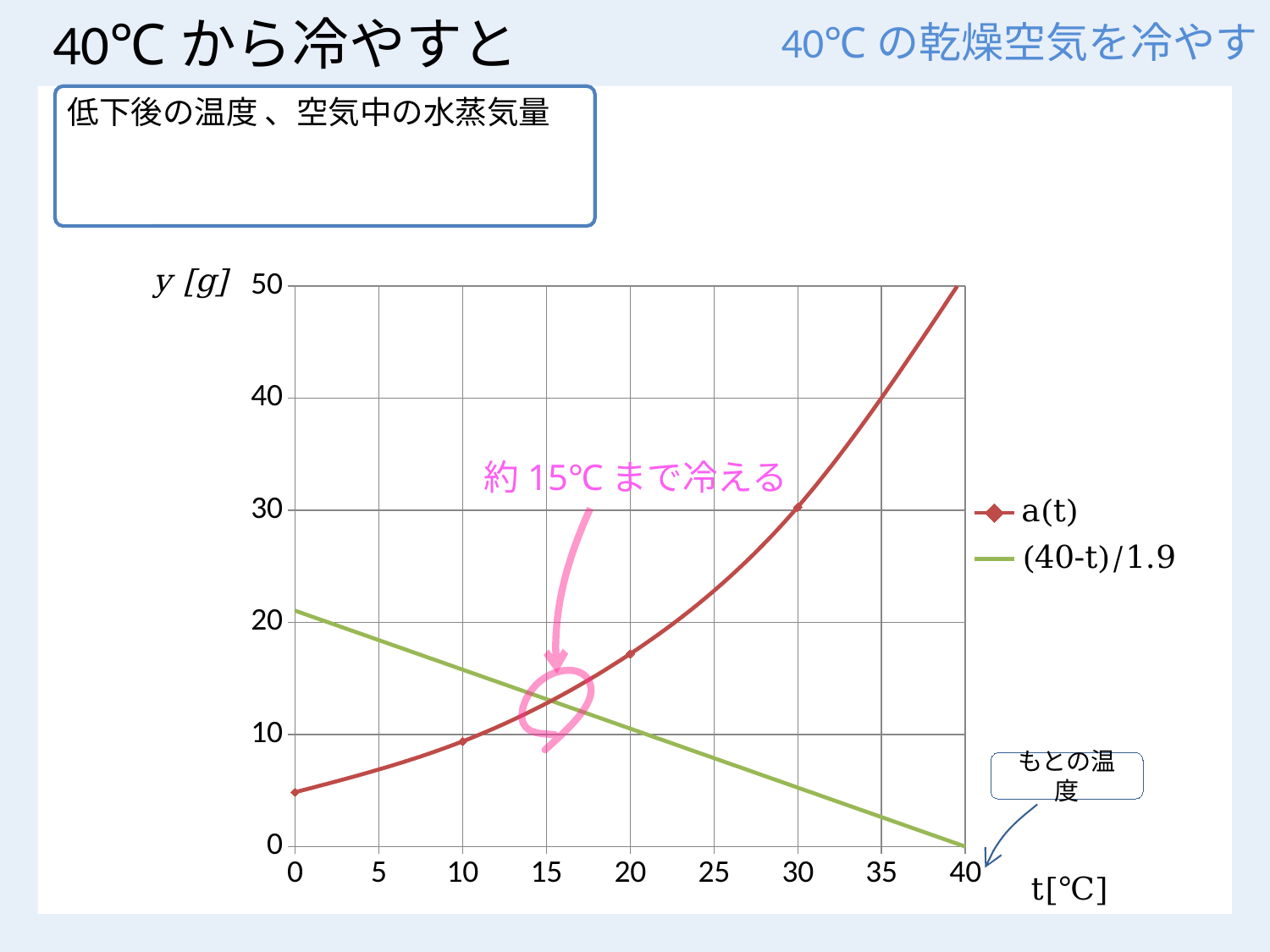
How many series does the chart legend list? 2 At t = 30, which series has the higher value, a(t) or (40-t)/1.9? a(t) What is the label of the horizontal axis of the chart? t[℃] What are the two series named in the chart legend? a(t) and (40-t)/1.9 Is the value of a(t) at t = 30 greater or less than 20? greater Is the value of the (40-t)/1.9 series at t = 0 greater or less than 30? less Is the value of a(t) at t = 0 greater or less than 10? less What kind of chart is shown on the slide? line chart Does the (40-t)/1.9 series rise or fall as t increases along the x axis? falls At t = 0, which series has the higher value, a(t) or (40-t)/1.9? (40-t)/1.9 What is the value of the (40-t)/1.9 series at t = 40? 0 Does the a(t) series rise or fall as t increases along the x axis? rises